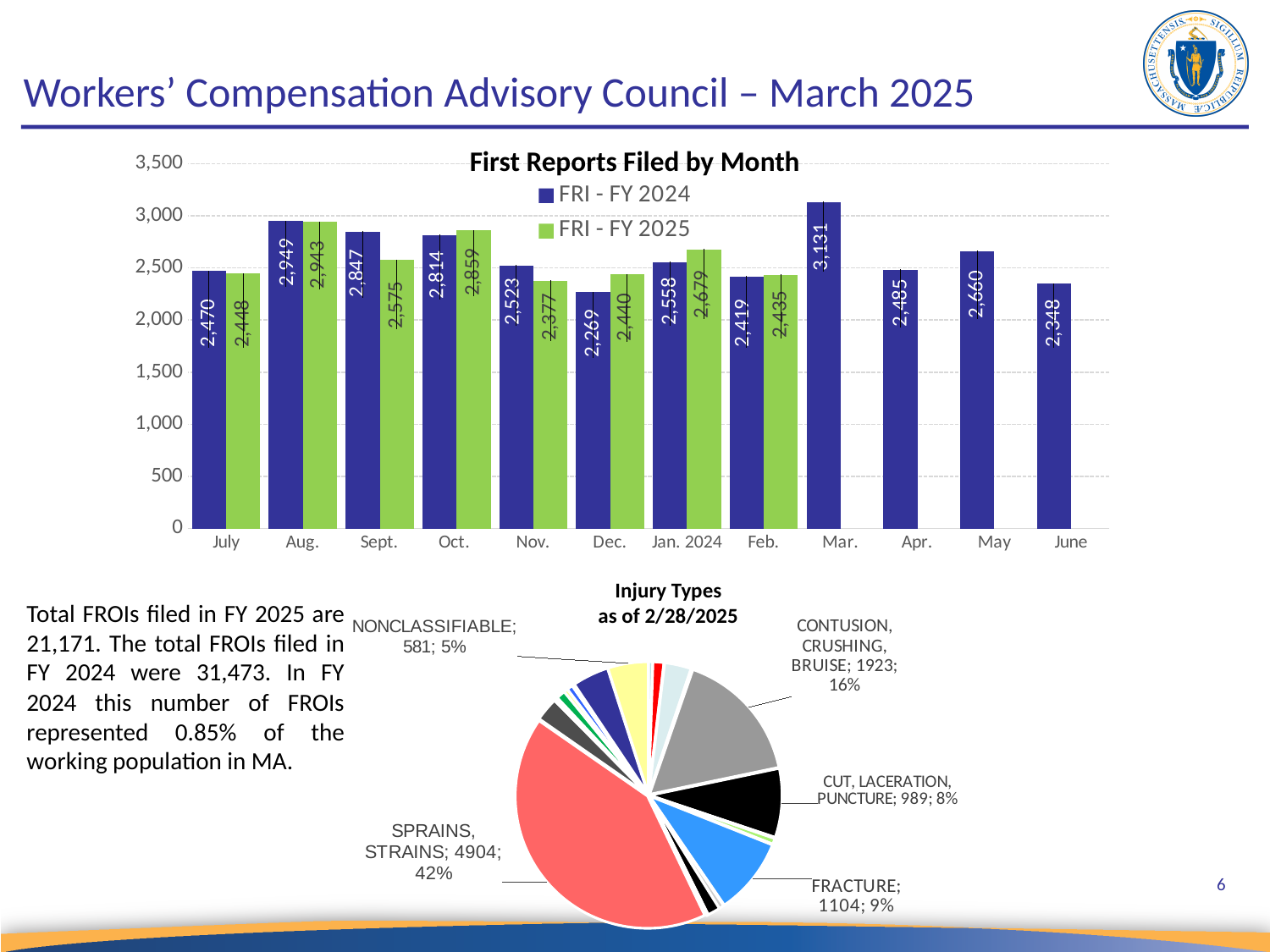
In the 'Injury Types as of 2/28/2025' pie chart, what share does SPRAINS, STRAINS represent? 42% In the 'First Reports Filed by Month' chart, what is the FRI - FY 2024 value for March? 3,131 In the 'First Reports Filed by Month' chart, which month has the highest FRI - FY 2024 value? Mar. In the 'First Reports Filed by Month' chart, what colour are the FRI - FY 2025 bars? Green In the 'First Reports Filed by Month' chart, how many months are shown on the x axis? 12 In the 'First Reports Filed by Month' chart, which month has the lowest FRI - FY 2024 value? Dec. In the 'Injury Types as of 2/28/2025' pie chart, what is the value for FRACTURE? 1104 In the 'First Reports Filed by Month' chart, what is the FRI - FY 2025 value for October? 2,859 What kind of chart is 'First Reports Filed by Month'? Bar chart In the 'First Reports Filed by Month' chart, which is larger for December: FRI - FY 2024 or FRI - FY 2025? FRI - FY 2025 In the 'First Reports Filed by Month' chart, what is the difference between the FRI - FY 2024 and FRI - FY 2025 values for September? 272 In the 'First Reports Filed by Month' chart, how many series does the legend list? 2